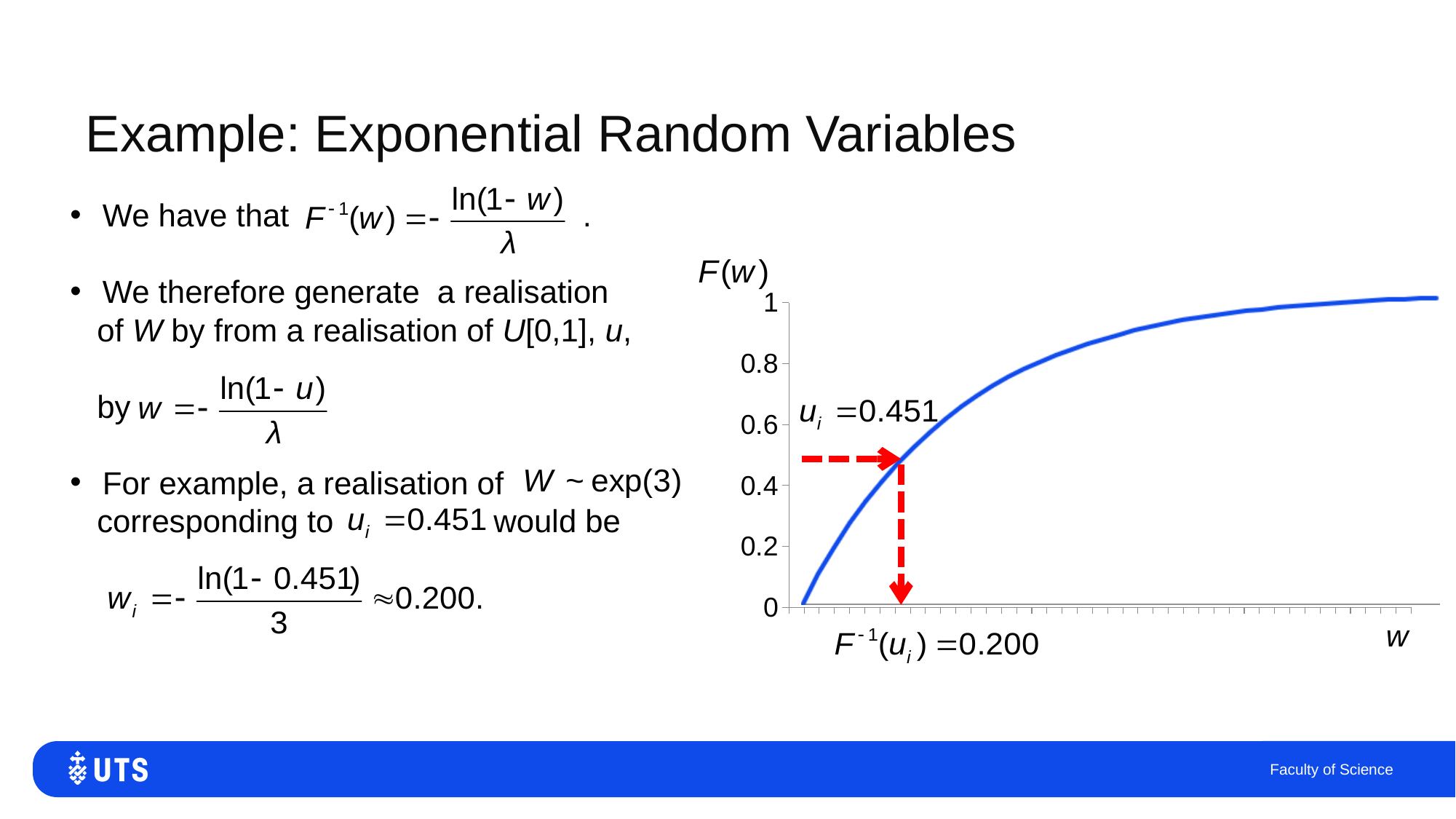
What is the value of u_i marked on the chart? 0.451 What kind of chart is shown on the slide? line chart What value of w does the red arrow point to on the horizontal axis, as labelled F^-1(u_i)? 0.200 What is the lowest tick value shown on the vertical axis of the chart? 0 Is the marked value u_i = 0.451 on the vertical axis greater or less than 0.6? less What is the highest tick value shown on the vertical axis of the chart? 1 Does the curve F(w) rise or fall as w increases? rise Is the marked value u_i = 0.451 on the vertical axis greater or less than 0.4? greater How many curves (series) are plotted on the chart? 1 What colour is the plotted curve on the chart? blue What is the label on the vertical axis of the chart? F(w)